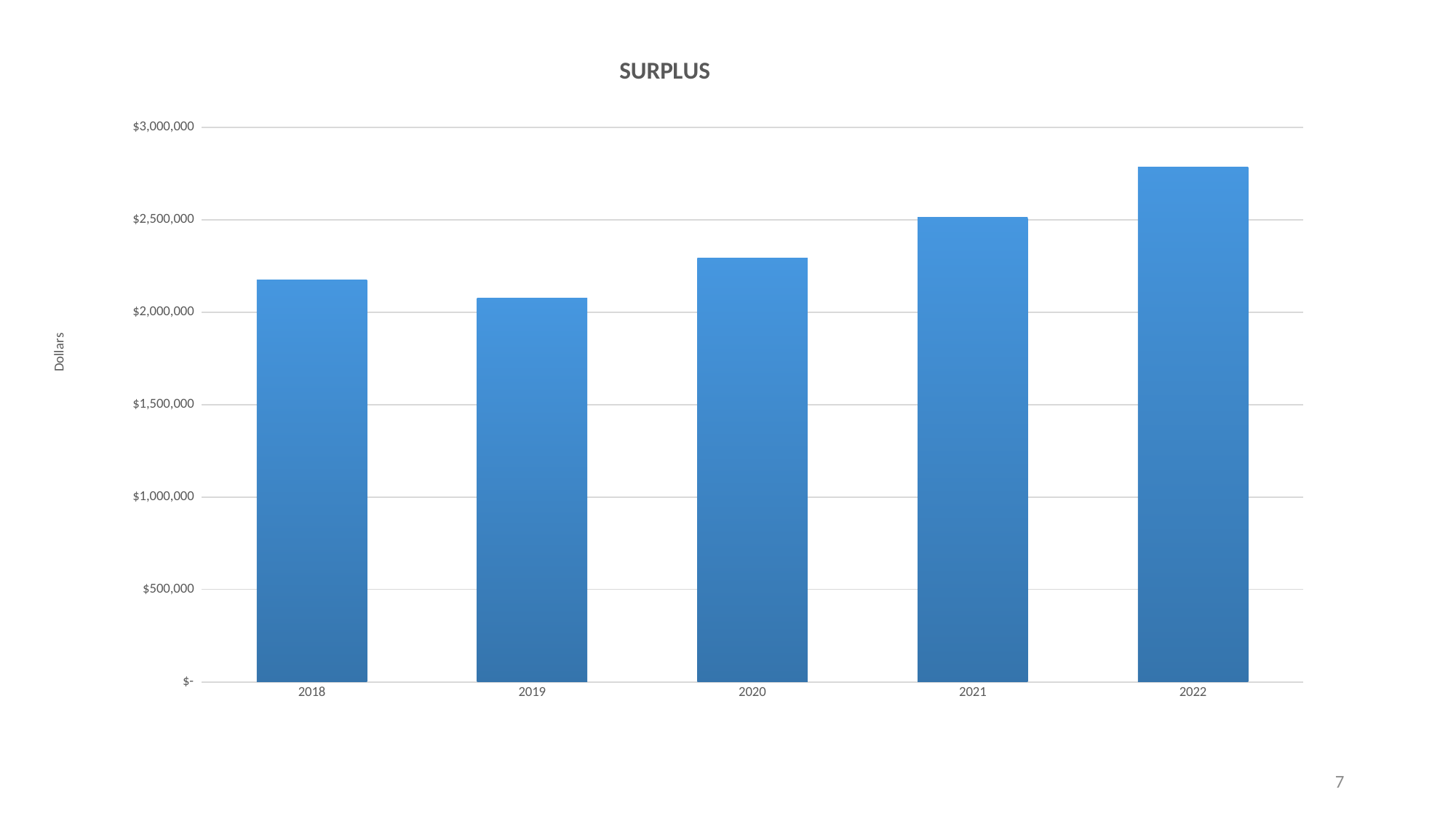
What is the label on the vertical axis of the chart? Dollars How many years are shown on the x axis of the chart? 5 Which year has the larger surplus, 2018 or 2020? 2020 Do the surplus values rise or fall from 2019 to 2022? rise Which year has the highest surplus? 2022 What kind of chart is shown on the slide? bar chart Is the surplus for 2019 greater or less than $2,500,000? less Which year has the lowest surplus? 2019 Is the surplus for 2022 greater or less than $3,000,000? less What is the title of the chart? SURPLUS Is the surplus for 2018 greater or less than $2,000,000? greater